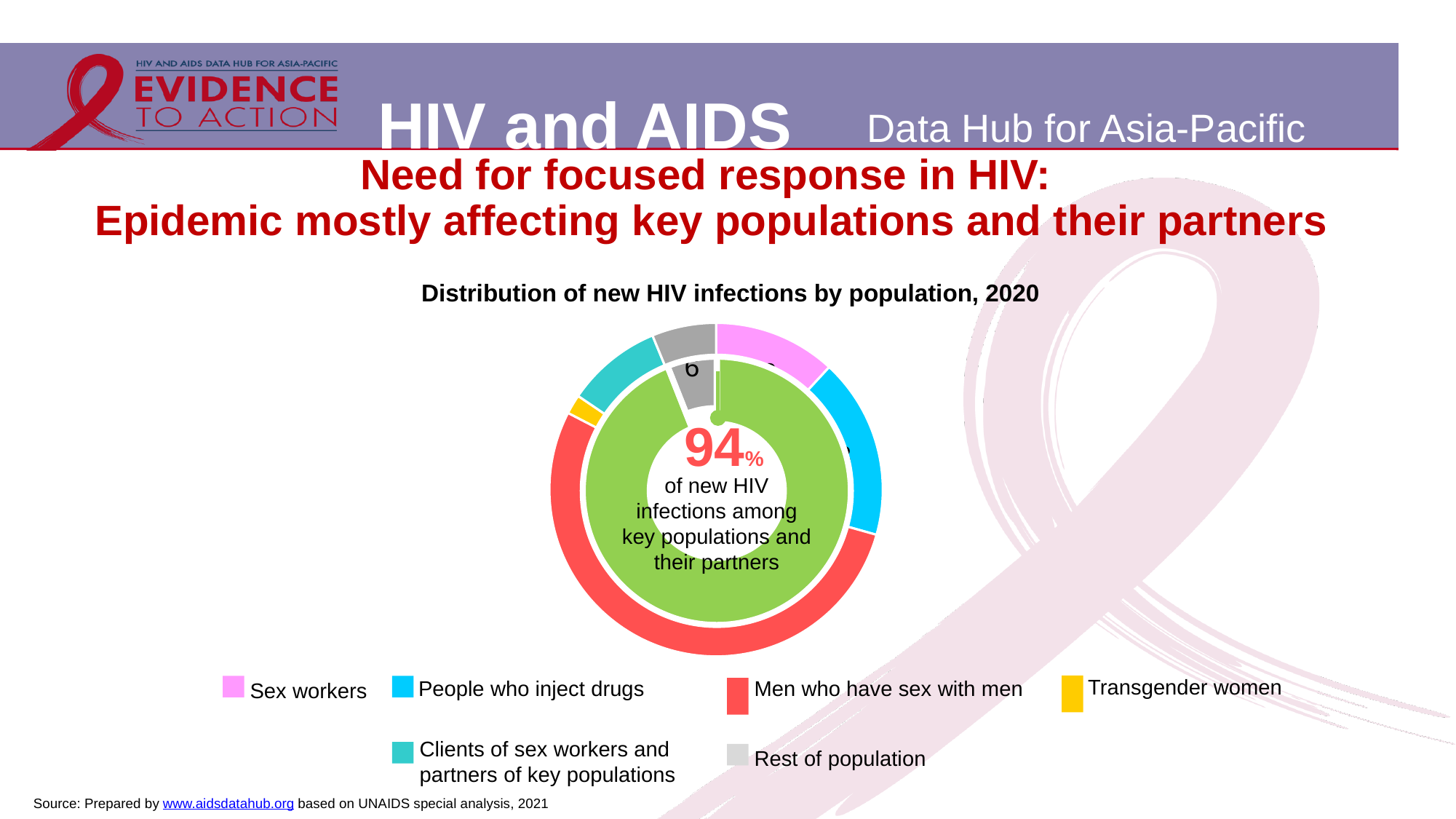
Which population accounts for the largest share of new HIV infections in the chart? Men who have sex with men How many population categories does the chart's legend list? 6 Which population accounts for the smallest share of new HIV infections in the chart? Transgender women What colour represents Rest of population in the chart? Grey What kind of chart is shown on the slide? pie chart (donut) Which slice is larger: People who inject drugs or Transgender women? People who inject drugs What is the title of the chart? Distribution of new HIV infections by population, 2020 Which year does the chart's data refer to? 2020 Which slice is larger: Men who have sex with men or Sex workers? Men who have sex with men Which slice is larger: Clients of sex workers and partners of key populations or Transgender women? Clients of sex workers and partners of key populations According to the chart's centre label, what percentage of new HIV infections are among key populations and their partners? 94%